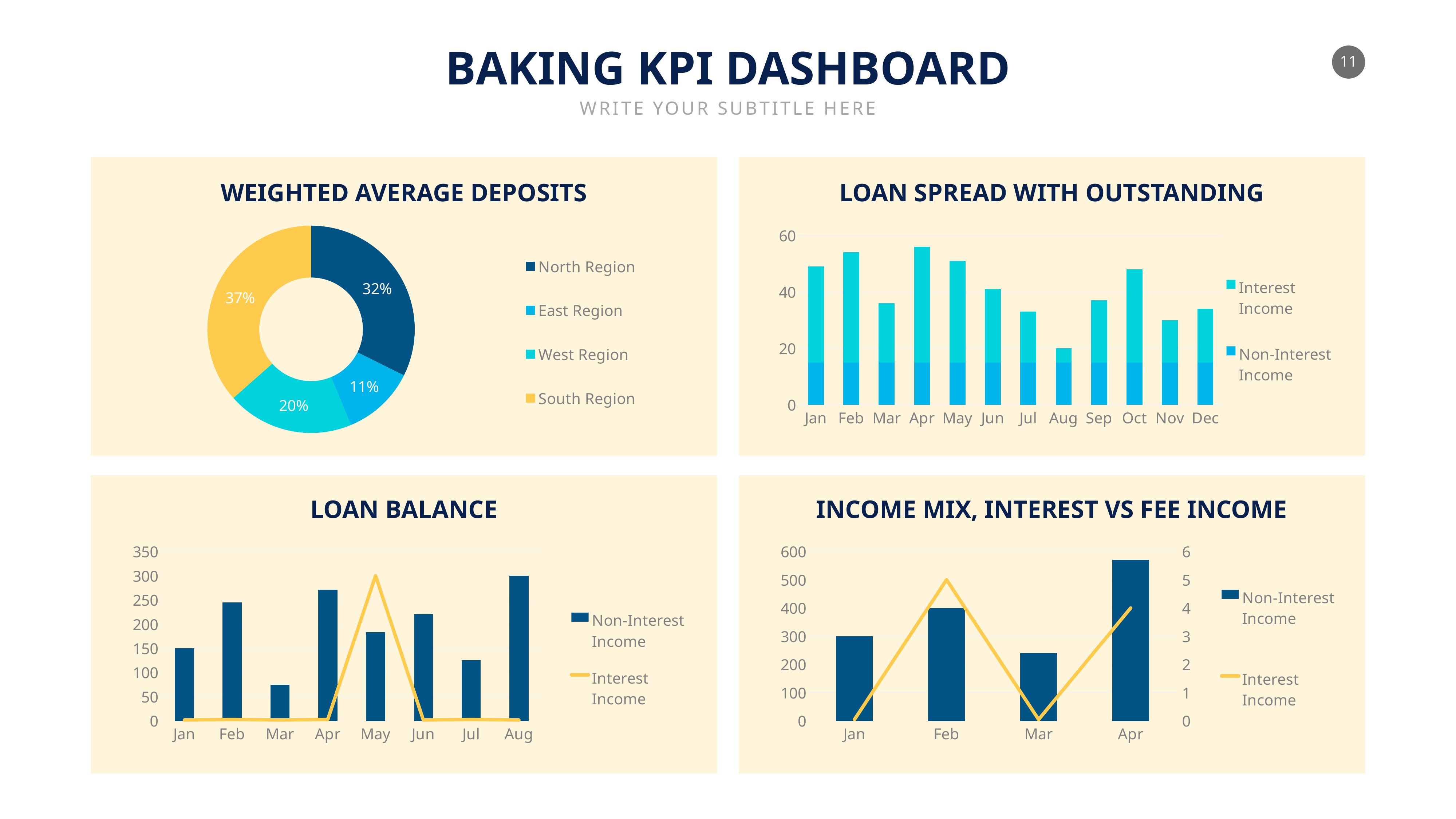
In the Loan Spread with Outstanding chart, is the total bar for Jul greater or less than 40? less In the Weighted Average Deposits chart, which region has the smallest share? East Region In the Income Mix, Interest vs Fee Income chart, is the Non-Interest Income bar for Mar greater or less than 300? less In the Loan Balance chart, is the Non-Interest Income bar for Feb greater or less than 200? greater In the Loan Spread with Outstanding chart, which month has the shortest stacked bar? Aug In the Weighted Average Deposits chart, what is the difference between the North Region and West Region shares? 12% In the Income Mix, Interest vs Fee Income chart, which month has the highest Non-Interest Income bar? Apr How many series does the legend of the Loan Spread with Outstanding chart list? 2 In the Loan Balance chart, which month has the lowest Non-Interest Income bar? Mar How many regions are shown in the Weighted Average Deposits chart? 4 In the Weighted Average Deposits chart, what share does the South Region have? 37% In the Loan Spread with Outstanding chart, which month has the tallest stacked bar? Apr